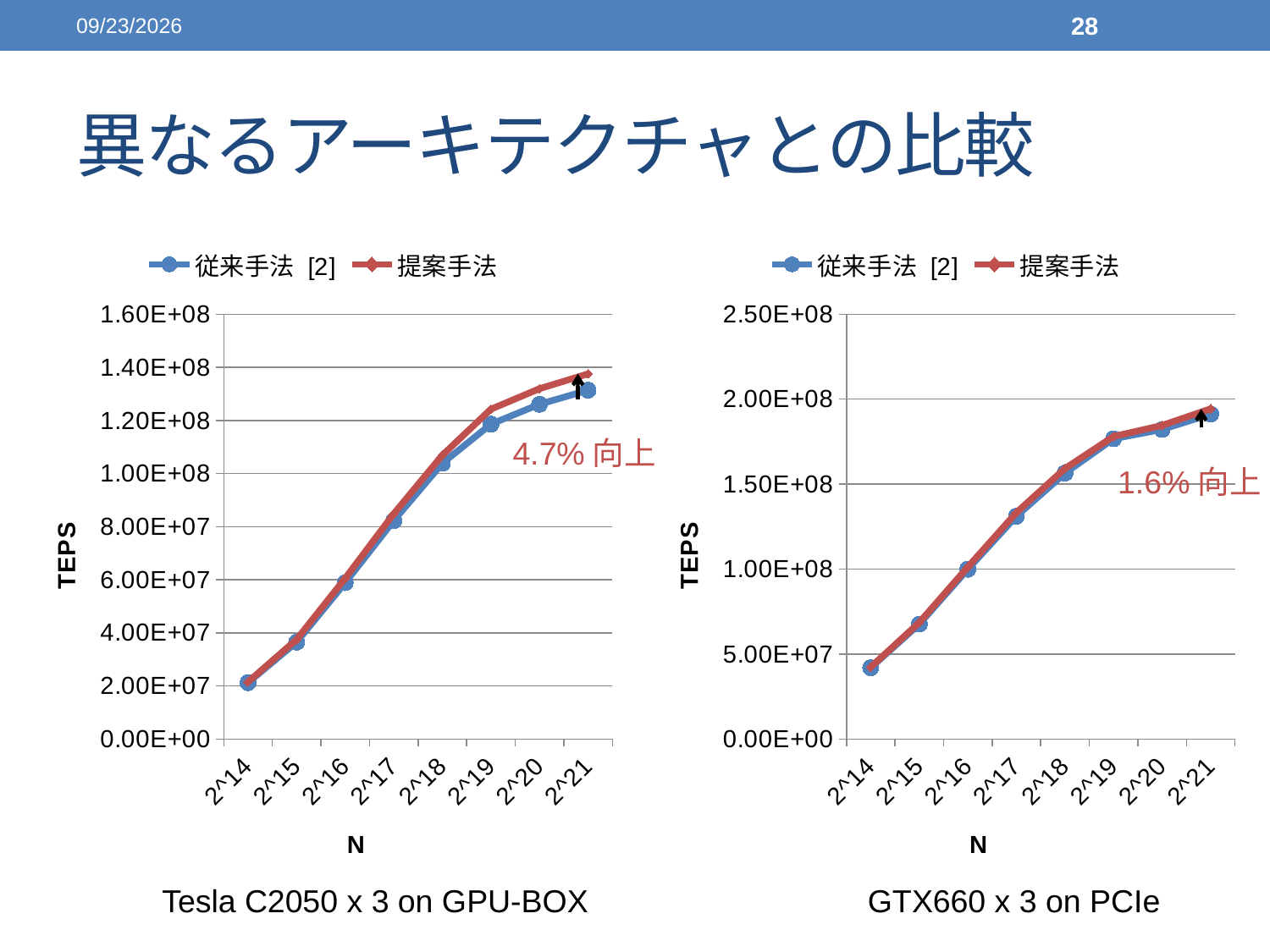
In the right chart (GTX660 x 3 on PCIe), is the 従来手法 [2] value at N = 2^14 greater or less than 5.00E+07? less What improvement percentage is annotated on the right chart (GTX660 x 3 on PCIe)? 1.6% In the left chart (Tesla C2050 x 3 on GPU-BOX), is the 従来手法 [2] value at N = 2^14 greater or less than 4.00E+07? less How many N values are plotted along the x axis of the left chart (Tesla C2050 x 3 on GPU-BOX)? 8 In the left chart (Tesla C2050 x 3 on GPU-BOX), at N = 2^21, which series has the larger TEPS value, 従来手法 [2] or 提案手法? 提案手法 What type of chart is the left chart (Tesla C2050 x 3 on GPU-BOX)? line chart In the left chart (Tesla C2050 x 3 on GPU-BOX), do the TEPS values rise or fall as N increases from 2^14 to 2^21? rise In the left chart (Tesla C2050 x 3 on GPU-BOX), is the 提案手法 value at N = 2^21 greater or less than 1.20E+08? greater In the right chart (GTX660 x 3 on PCIe), at which N does the 提案手法 series reach its highest TEPS value? 2^21 How many series does the legend of the right chart (GTX660 x 3 on PCIe) list? 2